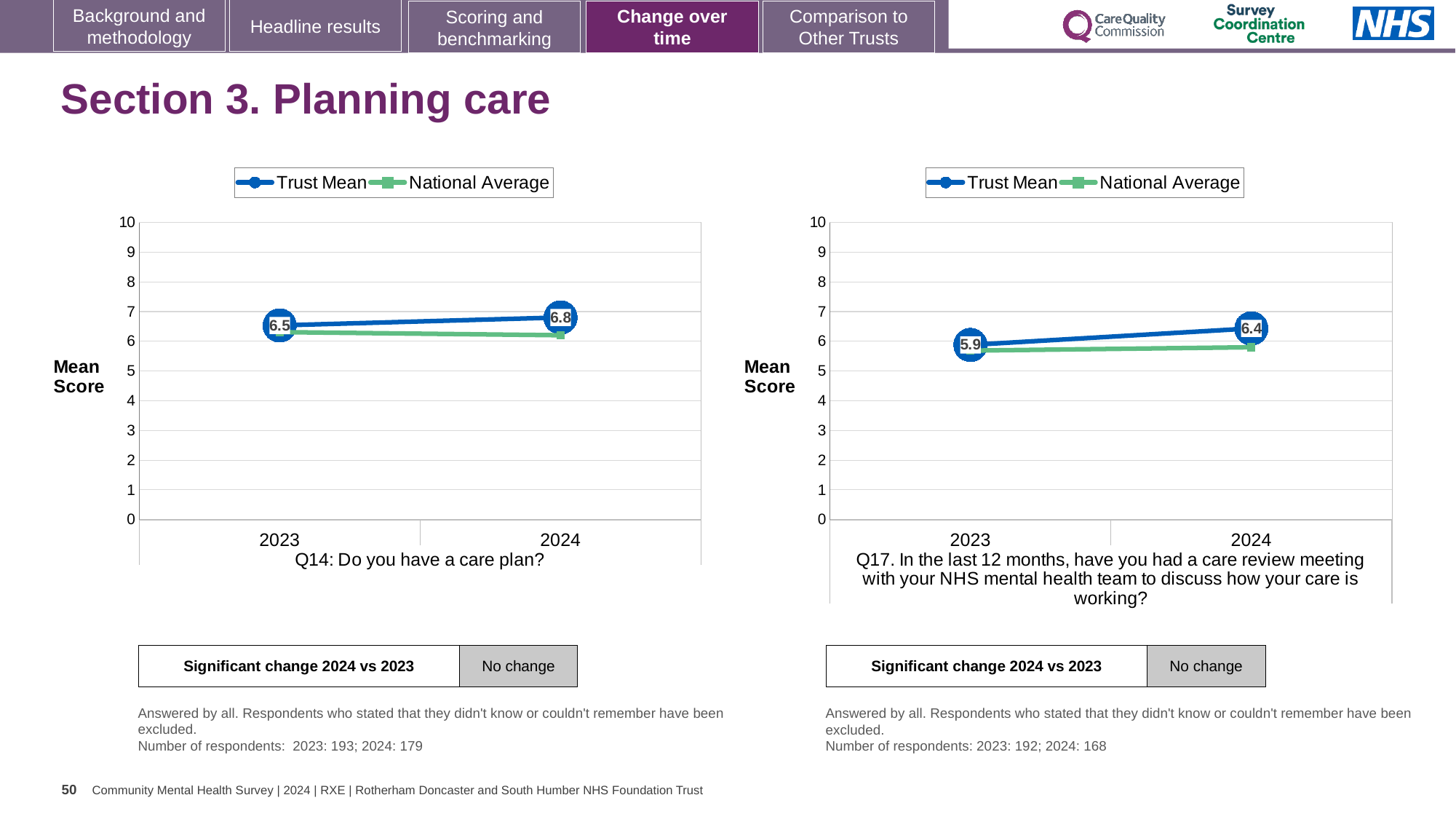
In the right chart (Q17, care review meeting), what is the Trust Mean score for 2024? 6.4 What kind of chart is the left chart (Q14: Do you have a care plan?)? line chart How many series does the legend of the left chart (Q14) list? 2 In the left chart (Q14: Do you have a care plan?), what is the Trust Mean score for 2023? 6.5 In the left chart (Q14: Do you have a care plan?), what is the Trust Mean score for 2024? 6.8 In the right chart (Q17, care review meeting), what is the Trust Mean score for 2023? 5.9 In the right chart (Q17), by how much did the Trust Mean change from 2023 to 2024? 0.5 In the left chart (Q14), by how much did the Trust Mean change from 2023 to 2024? 0.3 In the right chart (Q17), is the National Average for 2023 greater or less than 5? greater In the right chart (Q17), which is larger in 2024, the Trust Mean or the National Average? Trust Mean In the right chart (Q17), does the Trust Mean rise or fall from 2023 to 2024? rise In the left chart (Q14), is the National Average for 2024 greater or less than 7? less